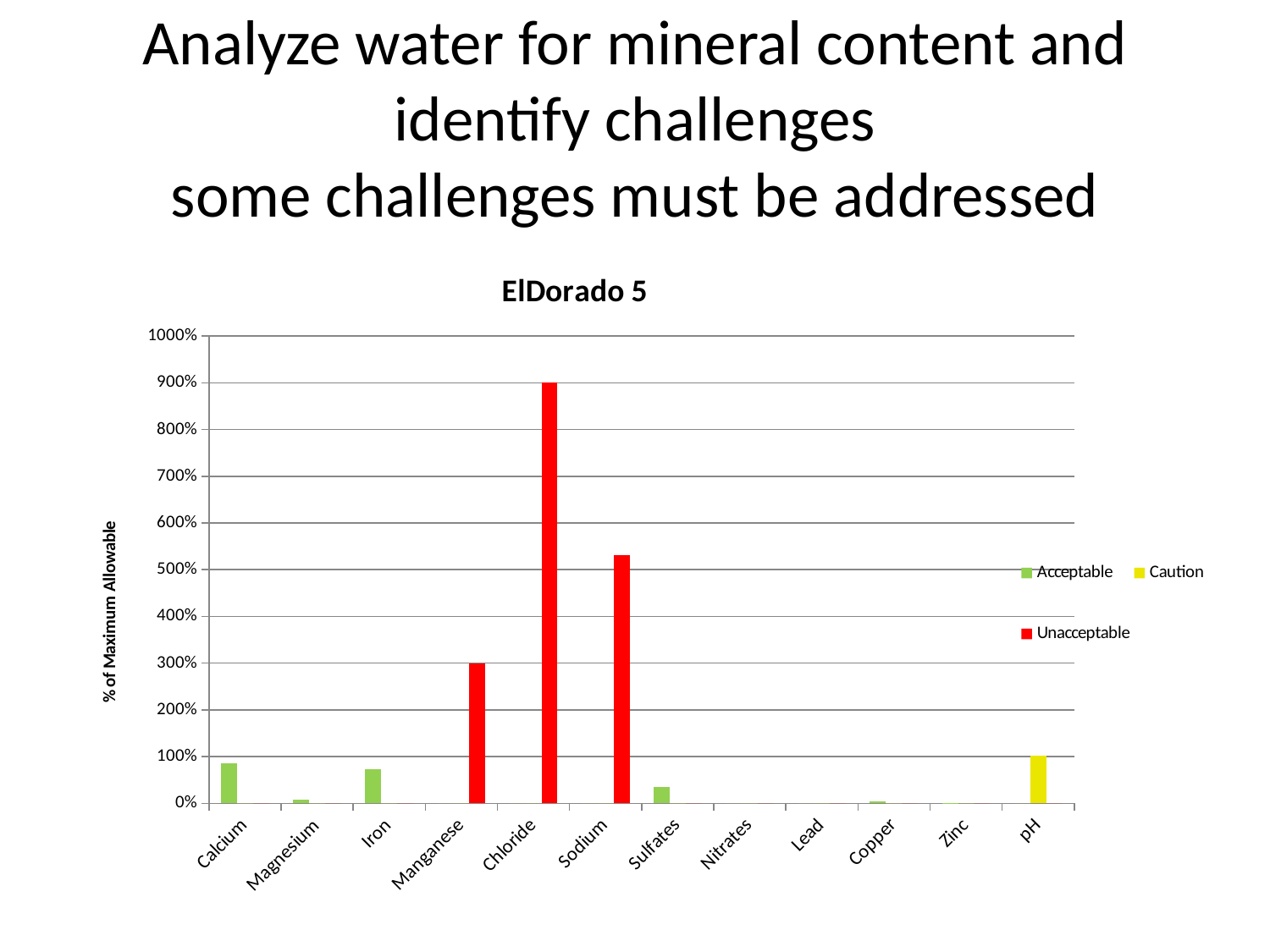
What kind of chart is shown on the slide? bar chart Which category has the highest value in the ElDorado 5 chart? Chloride What is the title of the chart? ElDorado 5 What is the value for Manganese? 300% How many categories are shown on the x axis of the chart? 12 What is the label on the vertical axis of the chart? % of Maximum Allowable Which is larger, the value for Manganese or the value for Sodium? Sodium Which is larger, the value for Calcium or the value for Iron? Calcium What is the value for Chloride? 900% How many series does the legend list? 3 Is the value for Sodium greater or less than 500%? greater Is the value for Calcium greater or less than 100%? less